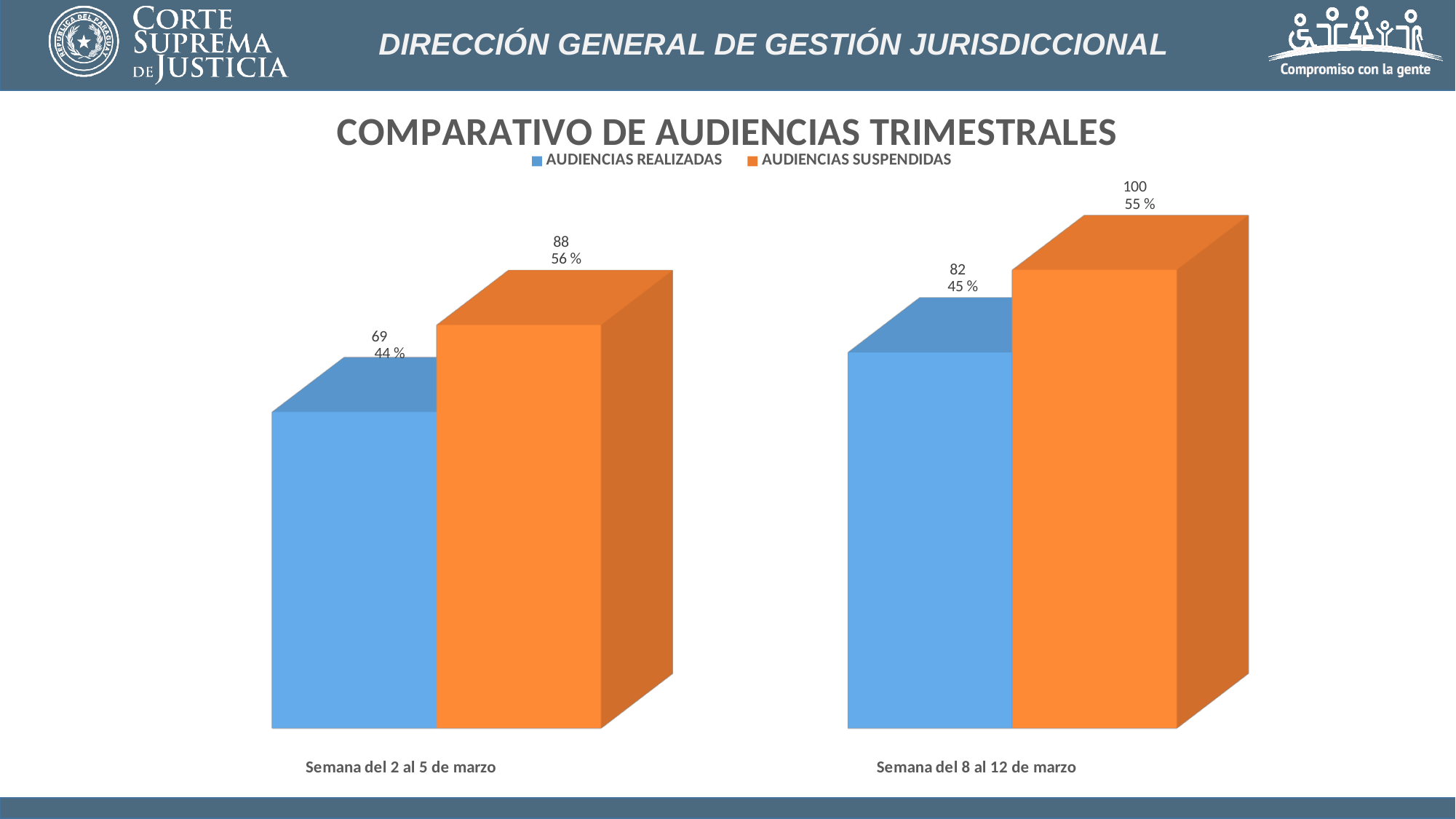
How many week categories are shown on the x axis? 2 What kind of chart is shown on the slide? Bar chart What percentage is shown for AUDIENCIAS REALIZADAS in Semana del 8 al 12 de marzo? 45 % What is the difference in AUDIENCIAS REALIZADAS between Semana del 8 al 12 de marzo and Semana del 2 al 5 de marzo? 13 Which week has the highest value for AUDIENCIAS SUSPENDIDAS? Semana del 8 al 12 de marzo What percentage is shown for AUDIENCIAS SUSPENDIDAS in Semana del 2 al 5 de marzo? 56 % Which is larger for Semana del 8 al 12 de marzo: AUDIENCIAS REALIZADAS or AUDIENCIAS SUSPENDIDAS? AUDIENCIAS SUSPENDIDAS What is the value of AUDIENCIAS SUSPENDIDAS for Semana del 8 al 12 de marzo? 100 What is the difference between AUDIENCIAS SUSPENDIDAS and AUDIENCIAS REALIZADAS for Semana del 2 al 5 de marzo? 19 How many series does the legend list? 2 Which week has the lowest value for AUDIENCIAS REALIZADAS? Semana del 2 al 5 de marzo What is the value of AUDIENCIAS REALIZADAS for Semana del 2 al 5 de marzo? 69